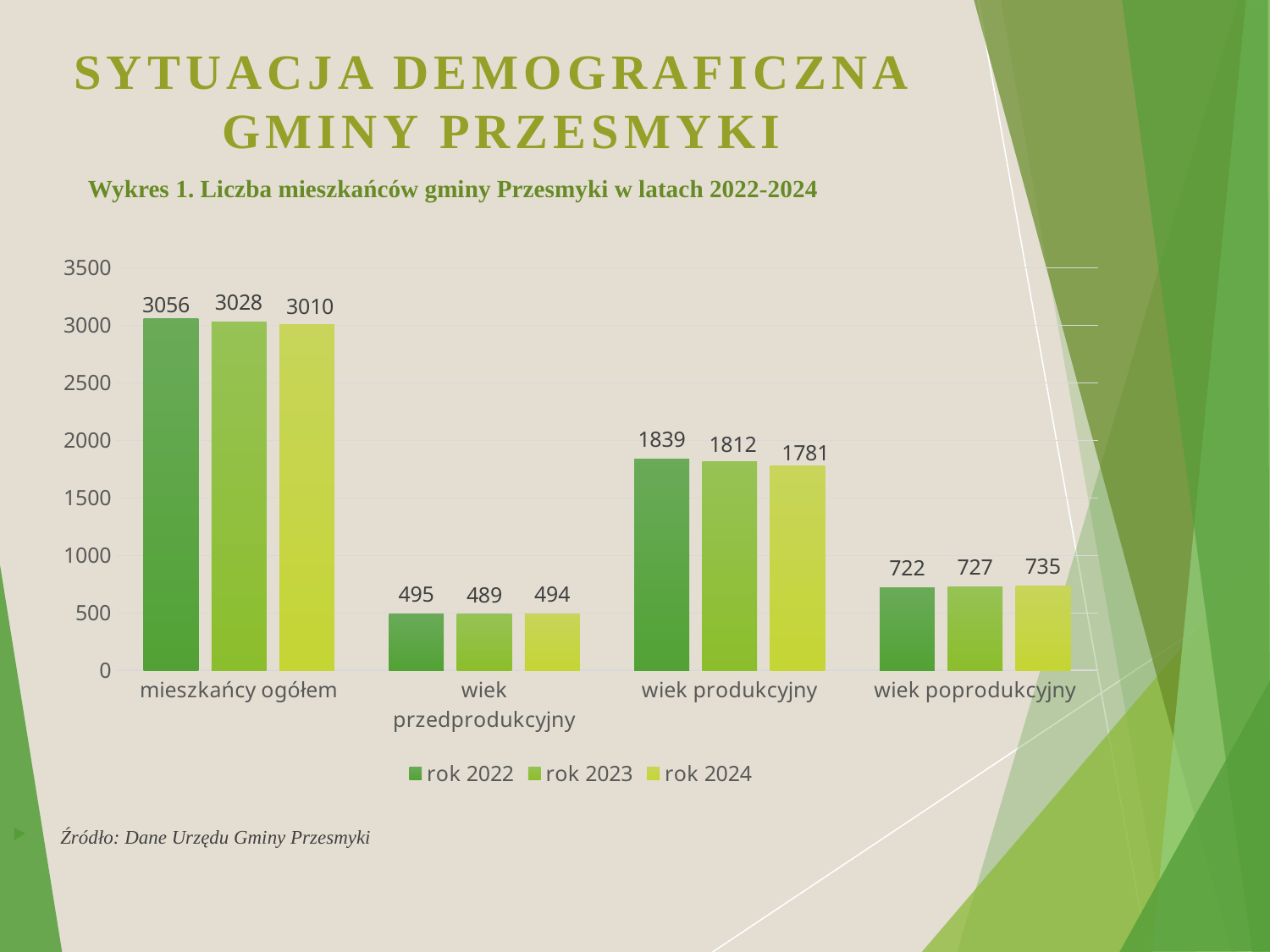
Which category has the highest value in the 'rok 2024' series? mieszkańcy ogółem What kind of chart is shown on the slide? bar chart What is the difference between the 'rok 2022' and 'rok 2023' values for 'wiek produkcyjny'? 27 What is the value for 'wiek poprodukcyjny' in the 'rok 2023' series? 727 What is the value for 'wiek produkcyjny' in the 'rok 2024' series? 1781 Do the values for 'wiek produkcyjny' rise or fall from 'rok 2022' to 'rok 2024'? fall What is the value for 'mieszkańcy ogółem' in the 'rok 2022' series? 3056 Which is larger: the 'rok 2022' value for 'wiek produkcyjny' or the 'rok 2022' value for 'wiek poprodukcyjny'? wiek produkcyjny How many series does the legend list? 3 How many categories are shown on the x axis? 4 Which category has the lowest value in the 'rok 2022' series? wiek przedprodukcyjny What is the difference between the 'rok 2022' and 'rok 2024' values for 'mieszkańcy ogółem'? 46